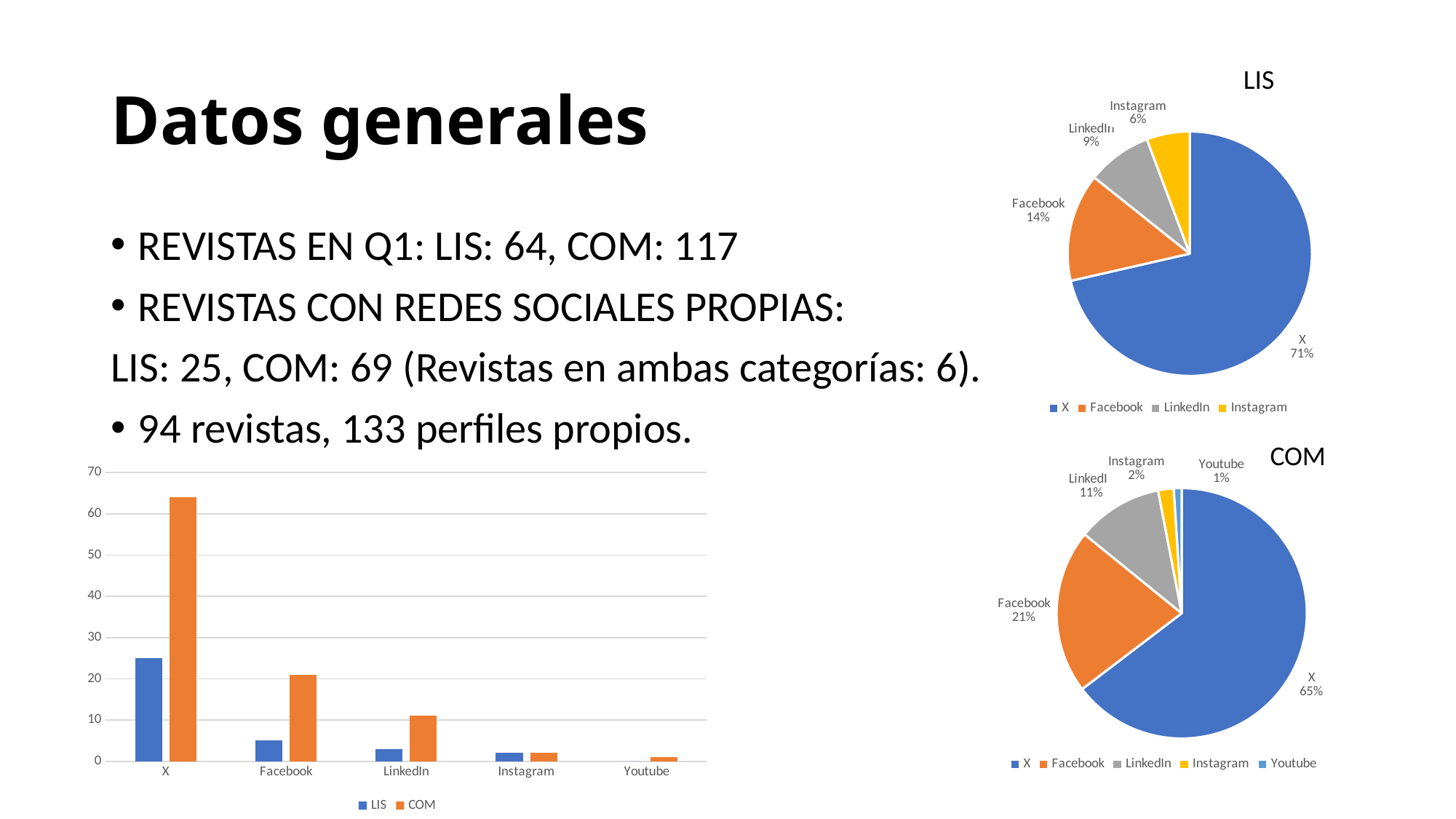
In the COM pie chart, what is the difference between the X share and the Facebook share? 44% In the bar chart at the bottom left, is the COM value for X greater or less than 60? greater In the LIS pie chart, what percentage is shown for Facebook? 14% What kind of chart is the chart at the bottom left of the slide? Bar chart In the COM pie chart, which platform has the smallest slice? Youtube How many slices does the COM pie chart have? 5 In the COM pie chart, what percentage is shown for LinkedIn? 11% In the bar chart at the bottom left, which category has the highest COM bar? X In the bar chart at the bottom left, how many series does the legend list? 2 In the COM pie chart, what share does Facebook have? 21% In the LIS pie chart, what share does X have? 71% In the LIS pie chart, which platform has the smallest slice? Instagram